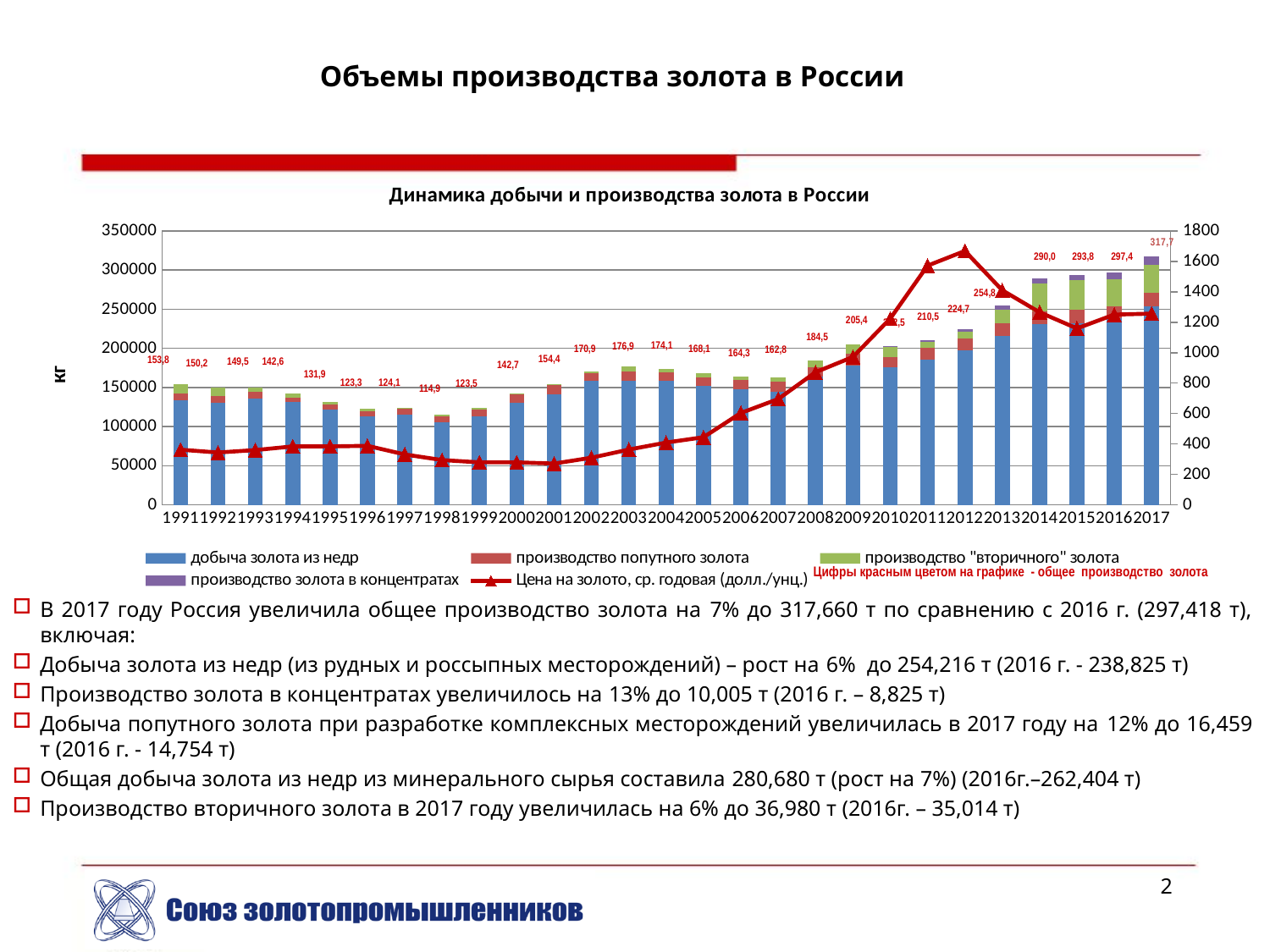
What total gold production figure (red label) is shown for 2017? 317,7 What total gold production figure (red label) is shown for 1998? 114,9 How many years are shown along the x axis of the chart? 27 What is the title of the chart on the slide? Динамика добычи и производства золота в России Is the stacked bar for 2017 greater or less than 300000 kg on the left axis? greater Do the red total production labels rise or fall from 2013 to 2017? rise Which year has the larger red total production label, 2013 or 2012? 2013 What is the difference between the red total production labels for 2017 and 2016? 20,3 What total gold production figure (red label) is shown for 2003? 176,9 Which year has the highest total gold production according to the red labels? 2017 Which year has the lowest total gold production according to the red labels? 1998 How many series does the chart legend list? 5